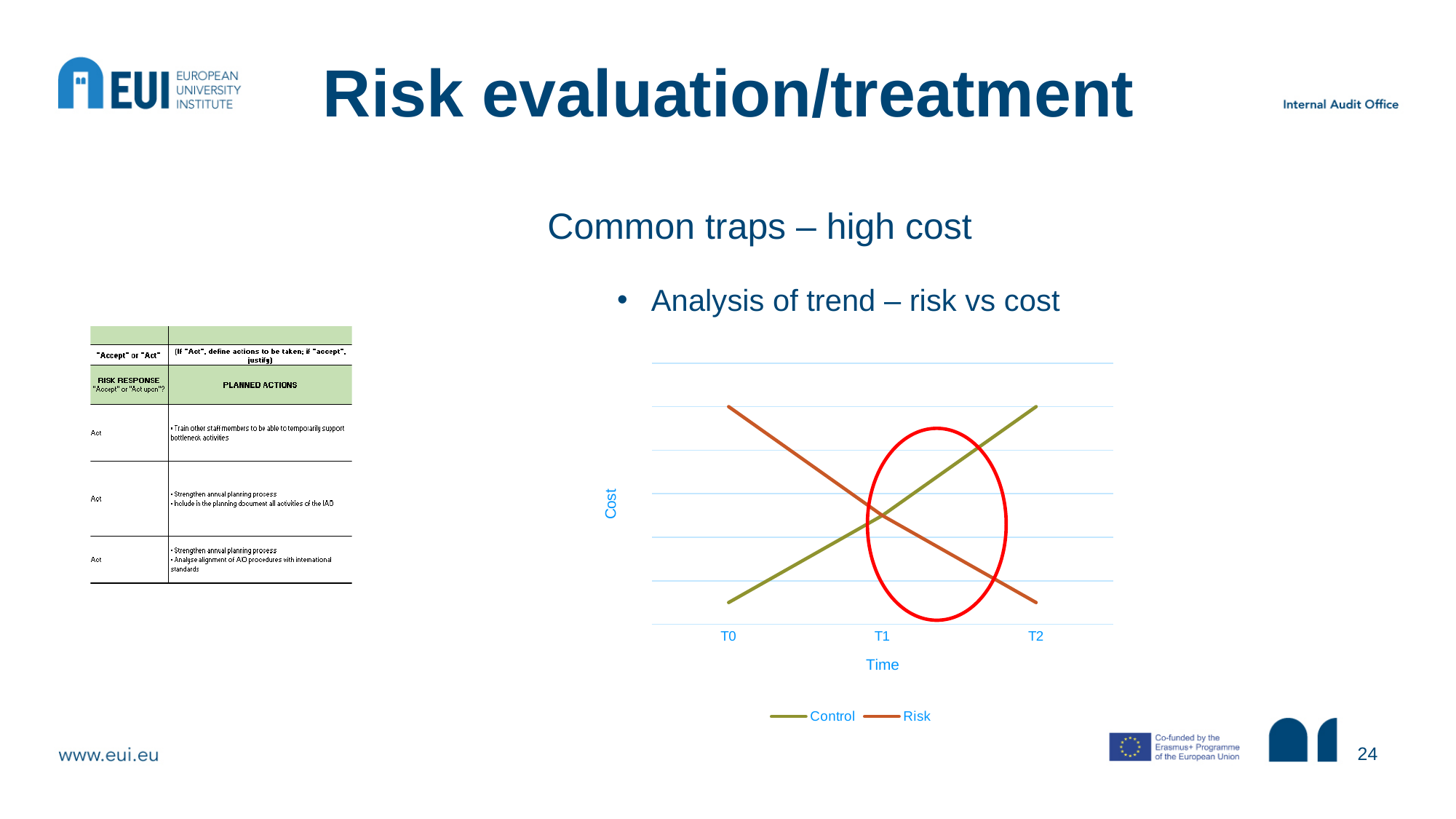
At T0, which series has the higher cost, Control or Risk? Risk What are the two series named in the chart's legend? Control and Risk What is the label of the chart's y axis? Cost At which labelled time point is the Control series at its highest? T2 Does the Risk series rise or fall from T0 to T2? Falls How many time points are labelled on the x axis of the chart? 3 At T2, which series has the higher cost, Control or Risk? Control At which labelled time point is the Risk series at its lowest? T2 What kind of chart is shown on the slide? Line chart Does the Control series rise or fall from T0 to T2? Rises How many series does the chart's legend list? 2